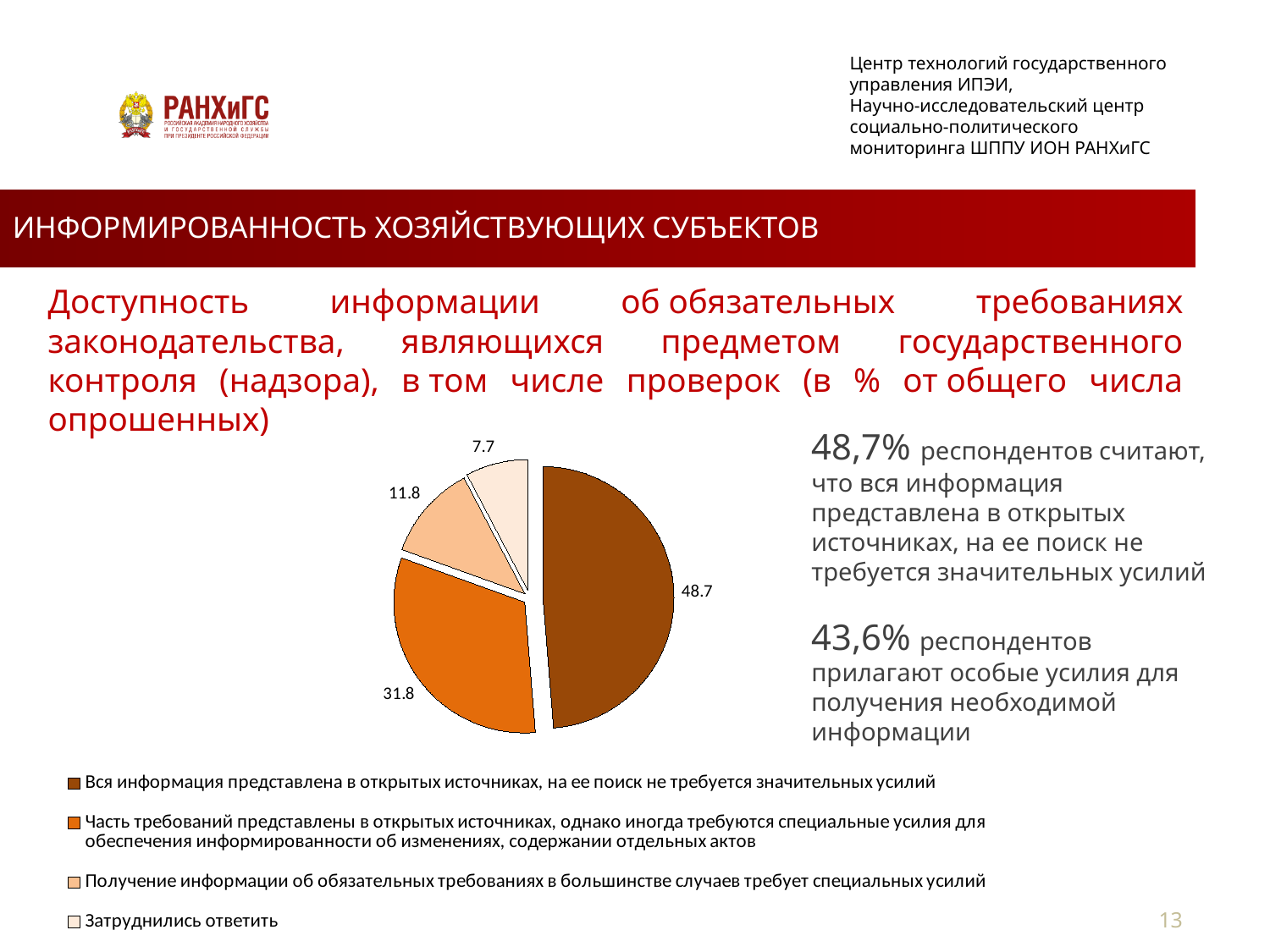
Which category has the smallest slice in the pie chart? Затруднились ответить What is the value of the slice for 'Затруднились ответить'? 7.7 How many slices does the pie chart have? 4 How many entries does the legend of the pie chart list? 4 What is the difference between the largest slice (48.7) and the second largest slice (31.8)? 16.9 What colour is the largest slice of the pie chart? dark brown What is the value of the slice for 'Получение информации об обязательных требованиях в большинстве случаев требует специальных усилий'? 11.8 What is the value of the slice for 'Часть требований представлены в открытых источниках, однако иногда требуются специальные усилия для обеспечения информированности об изменениях, содержании отдельных актов'? 31.8 Which is larger: the slice for 'Получение информации об обязательных требованиях в большинстве случаев требует специальных усилий' or the slice for 'Затруднились ответить'? Получение информации об обязательных требованиях в большинстве случаев требует специальных усилий What is the value of the slice for 'Вся информация представлена в открытых источниках, на ее поиск не требуется значительных усилий'? 48.7 What type of chart is shown on the slide? pie chart Which category has the largest slice in the pie chart? Вся информация представлена в открытых источниках, на ее поиск не требуется значительных усилий